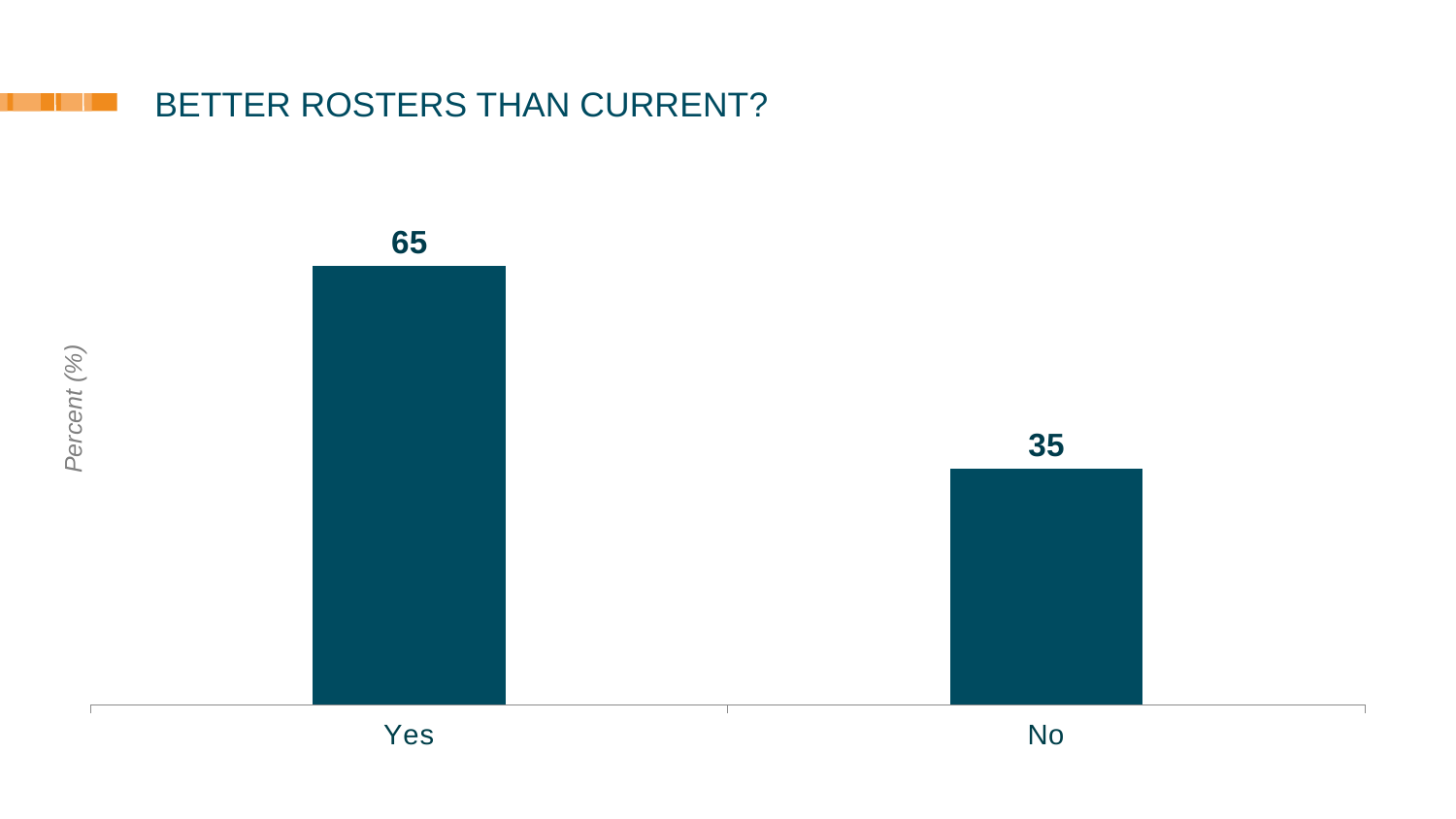
What is the value for Yes? 65 What is the value for No? 35 What kind of chart is shown on the slide? Bar chart How many categories are shown on the x axis? 2 Which category has the lowest value? No What is the total of the values for Yes and No? 100 Which category has the highest value? Yes What is the title of the slide? BETTER ROSTERS THAN CURRENT? What is the difference between the values for Yes and No? 30 Which is larger, the value for Yes or the value for No? Yes What is the label on the vertical axis? Percent (%) Do the values rise or fall from Yes to No along the x axis? Fall